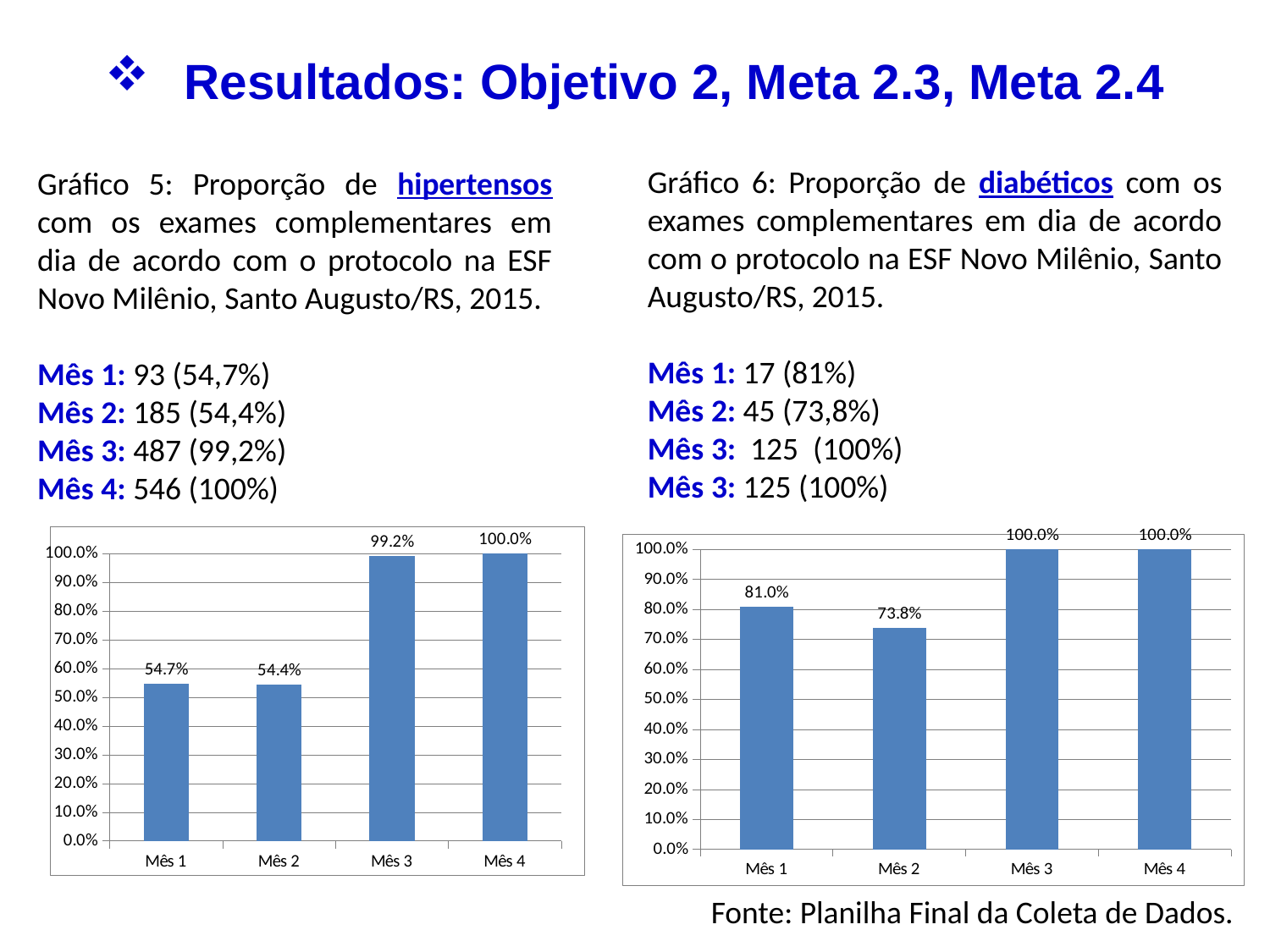
In the left chart (Gráfico 5, hipertensos), is the value for Mês 1 greater or less than 60%? less What type of chart is the left chart (Gráfico 5, hipertensos)? Bar chart In the right chart (Gráfico 6, diabéticos), which month has the lowest value? Mês 2 In the left chart (Gráfico 5, hipertensos), what is the difference between the values for Mês 3 and Mês 1? 44.5 percentage points In the left chart (Gráfico 5, hipertensos), what is the value for Mês 3? 99.2% In the right chart (Gráfico 6, diabéticos), what is the value for Mês 2? 73.8% How many bars are shown in the right chart (Gráfico 6, diabéticos)? 4 In the left chart (Gráfico 5, hipertensos), what is the value for Mês 1? 54.7% In the left chart (Gráfico 5, hipertensos), which month has the highest value? Mês 4 In the right chart (Gráfico 6, diabéticos), what is the difference between the values for Mês 1 and Mês 2? 7.2 percentage points In the right chart (Gráfico 6, diabéticos), which is larger, the value for Mês 1 or Mês 2? Mês 1 In the right chart (Gráfico 6, diabéticos), what is the value for Mês 1? 81.0%